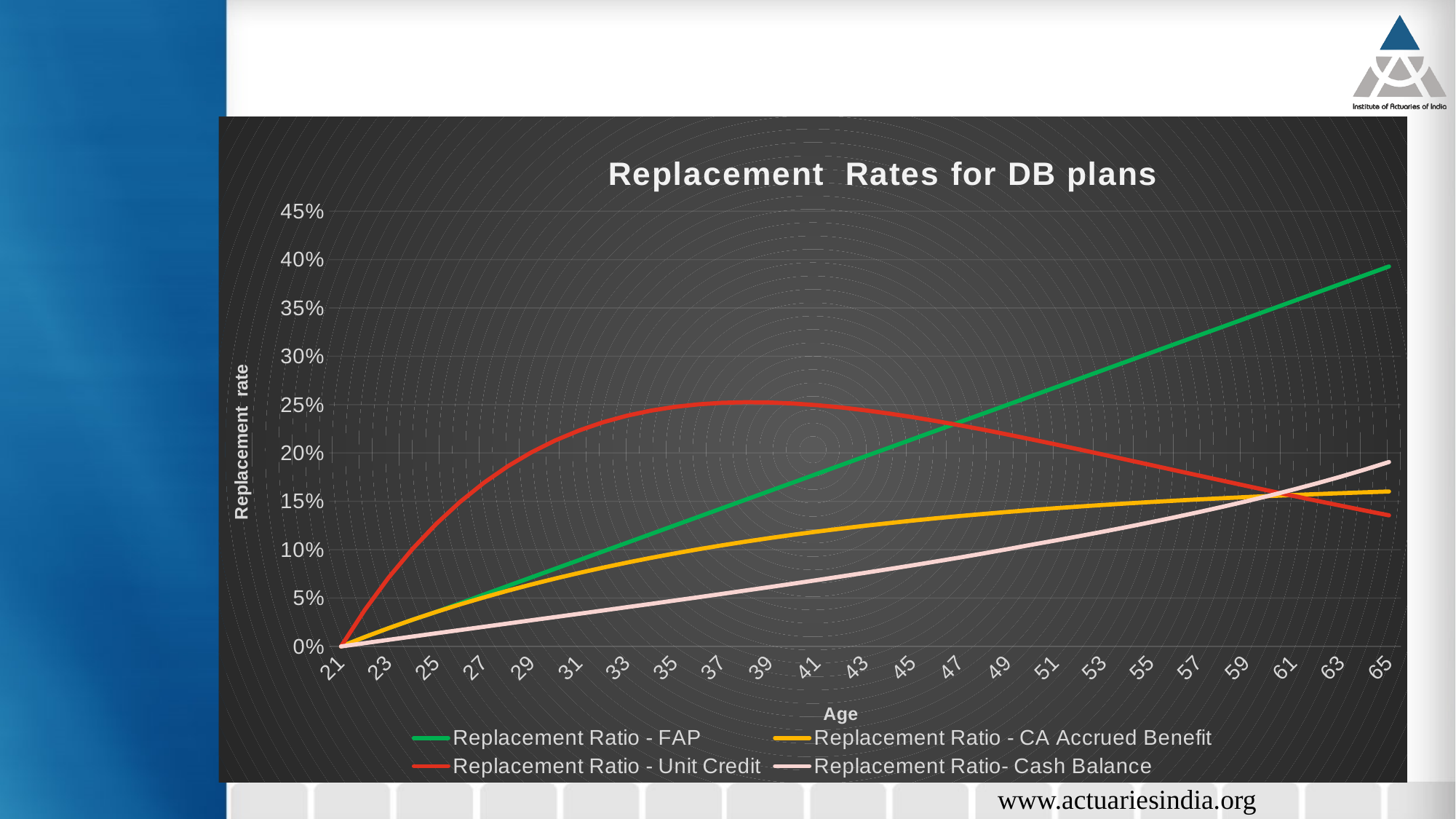
How many series does the legend list? 4 Is the peak value of Replacement Ratio - Unit Credit greater or less than 20%? greater Which series has the highest value at age 65? Replacement Ratio - FAP Which series has the lowest value at age 65? Replacement Ratio - Unit Credit How many age labels are shown along the x axis? 23 Does Replacement Ratio - FAP rise or fall as age increases from 21 to 65? rise What is the value of Replacement Ratio - FAP at age 21? 0% Is the value for Replacement Ratio - Unit Credit at age 65 greater or less than 15%? less What is the title of the chart? Replacement Rates for DB plans Is the value for Replacement Ratio - FAP at age 65 greater or less than 35%? greater What kind of chart is shown on the slide? line chart What is the label of the x axis? Age